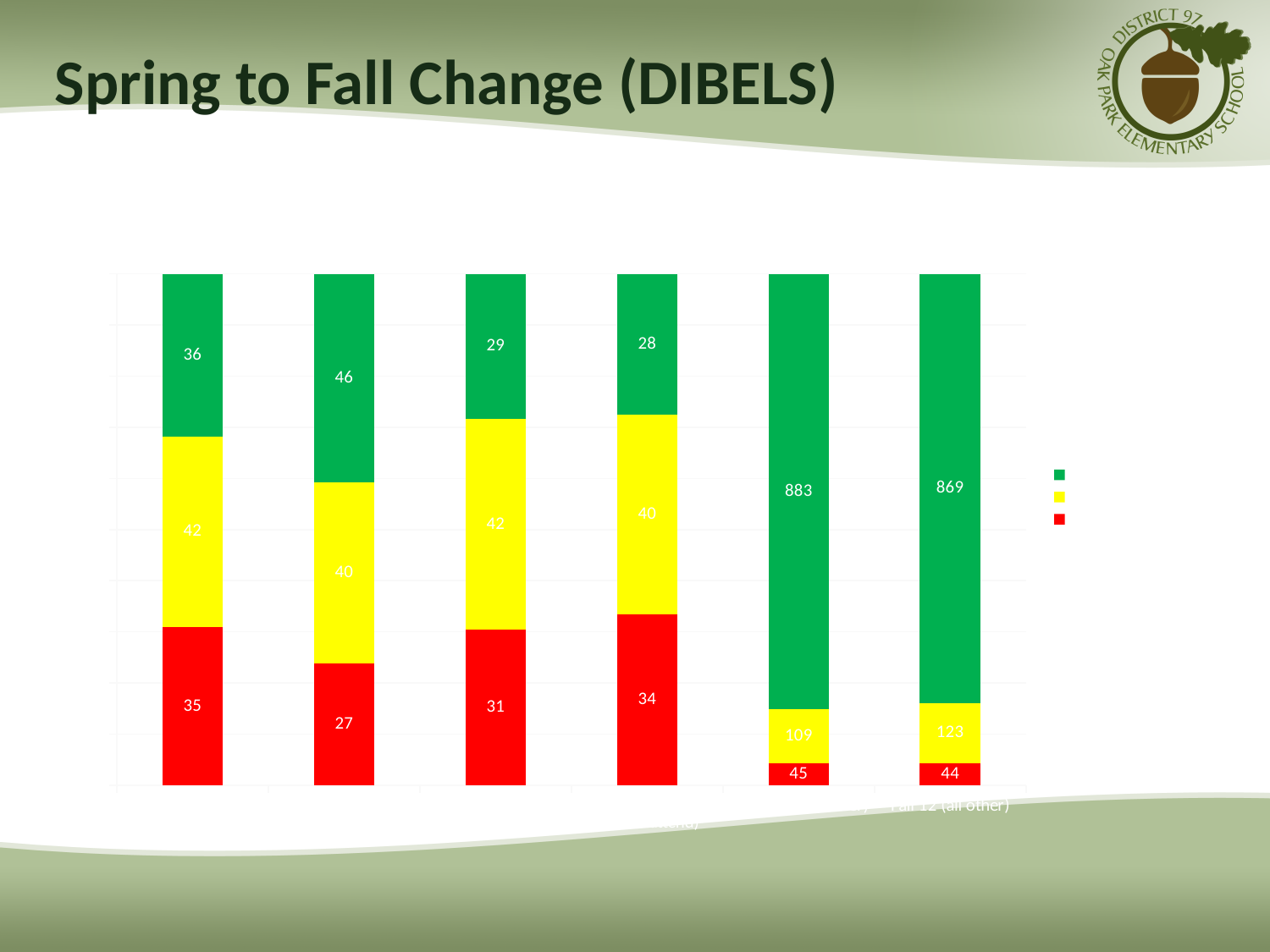
How many stacked bars are plotted in the chart? 6 What kind of chart is shown on the slide? Bar chart How many series does the legend list? 3 What is the value of the green segment of the first (leftmost) bar? 36 What is the total of the fifth stacked bar from the left? 1037 What is the title of the chart on the slide? Spring to Fall Change (DIBELS) What is the value of the yellow segment of the sixth (rightmost) bar? 123 What is the difference between the green segment of the fifth bar and the green segment of the sixth bar? 14 What is the value of the red segment of the fifth bar from the left? 45 What is the total of the first (leftmost) stacked bar? 113 What is the value of the yellow segment of the second bar from the left? 40 Which bar has the largest green segment? The fifth bar from the left (883)